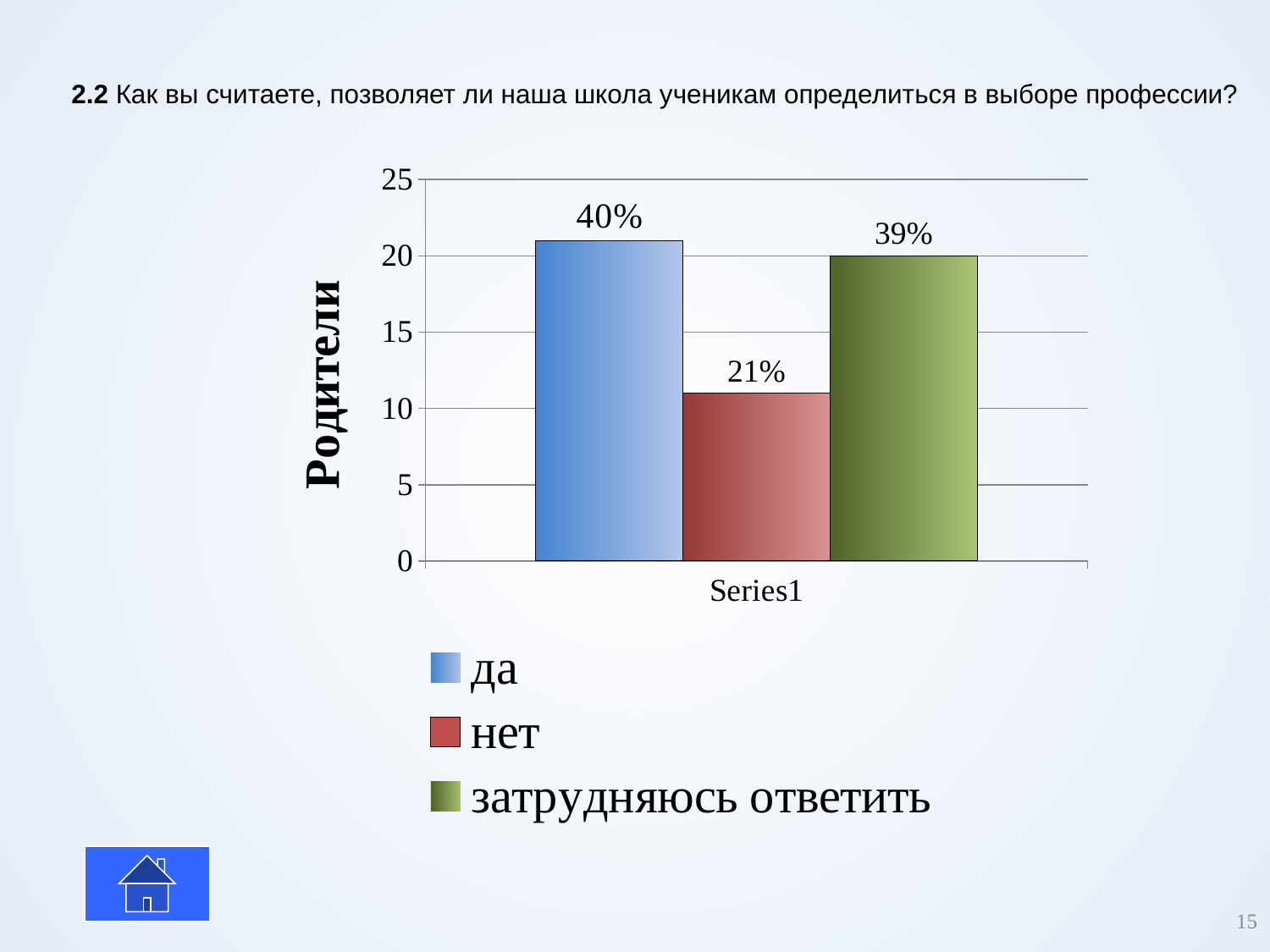
What kind of chart is shown on the slide? bar chart What is the title of the vertical axis? Родители Is the bar for "нет" greater or less than 15 on the vertical axis? less Which is larger, the value for "да" or the value for "нет"? да What colour is the bar for "затрудняюсь ответить"? green What value is shown for "да"? 40% Which response has the lowest value? нет How many series does the legend list? 3 Which response has the highest value? да What value is shown for "затрудняюсь ответить"? 39% What is the difference between the values for "да" and "нет"? 19% What value is shown for "нет"? 21%